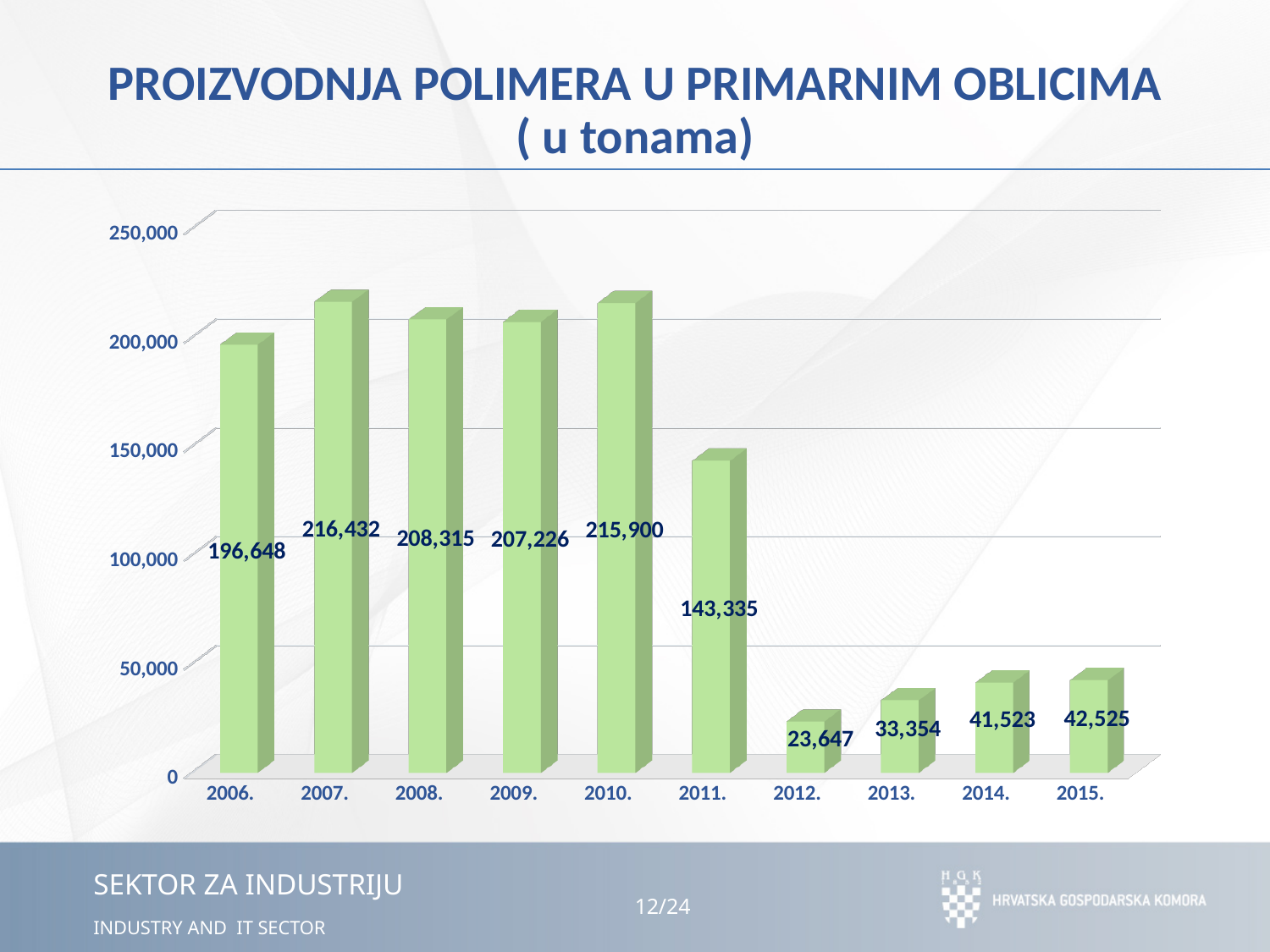
What is the value for 2011.? 143,335 What is the value for 2006.? 196,648 Which year has the highest value? 2007. What is the difference between the values for 2007. and 2006.? 19,784 What kind of chart is shown on the slide? bar chart Which is larger, the value for 2008. or the value for 2009.? 2008. What is the difference between the values for 2011. and 2012.? 119,688 How many years are shown on the x axis? 10 What is the value for 2015.? 42,525 Which year has the lowest value? 2012. What is the title of the chart? PROIZVODNJA POLIMERA U PRIMARNIM OBLICIMA ( u tonama) Is the value for 2010. greater or less than 200,000? greater